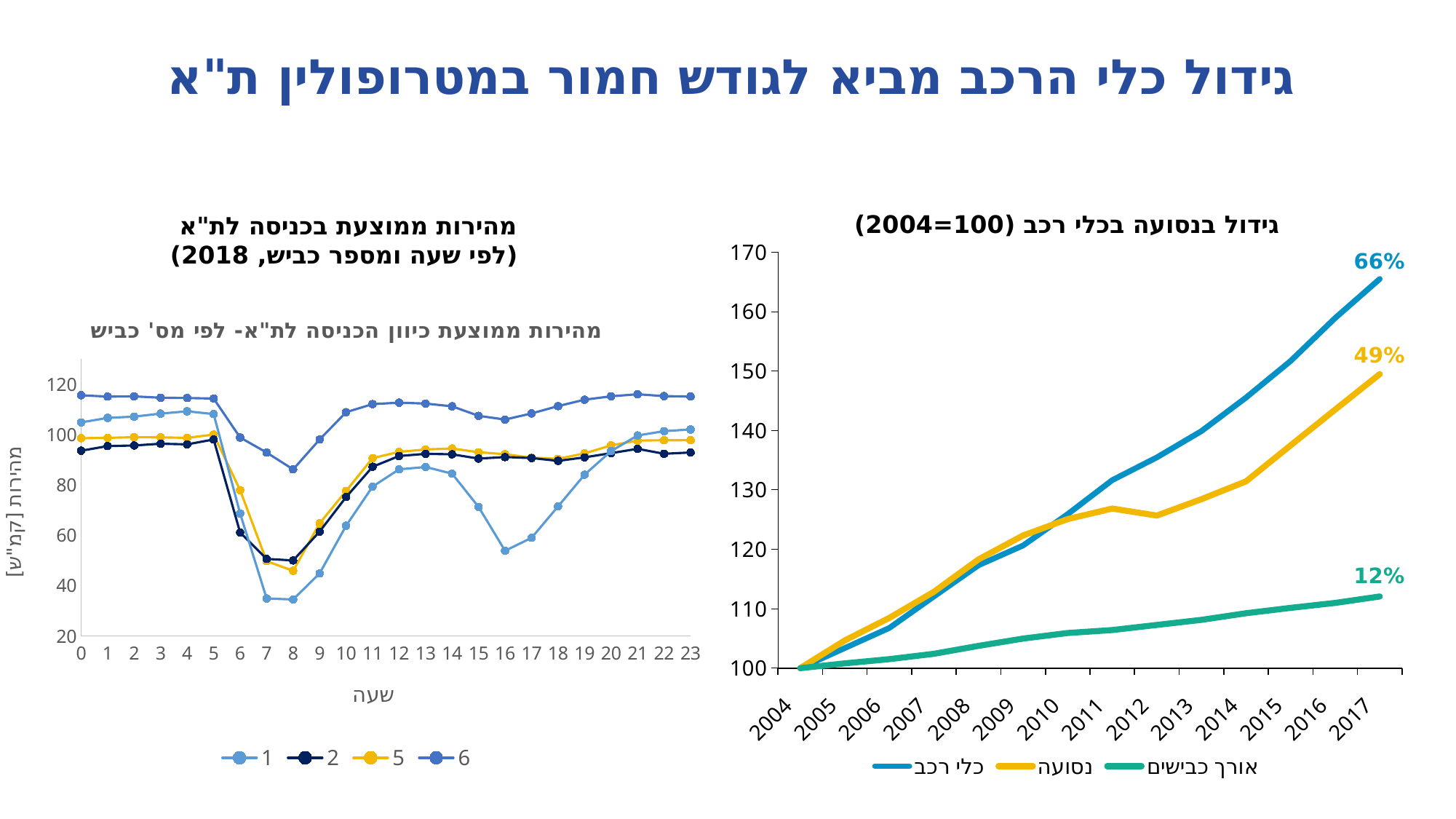
How many series does the legend of the right-hand chart (גידול בנסועה בכלי רכב) list? 3 In the left-hand chart (מהירות ממוצעת בכניסה לת"א), is the value for series 1 at hour 7 greater or less than 40? less In the right-hand chart (גידול בנסועה בכלי רכב), how many years are shown on the x axis? 14 In the right-hand chart (גידול בנסועה בכלי רכב), which series shows the highest growth by 2017? כלי רכב In the right-hand chart (גידול בנסועה בכלי רכב), what percentage label is shown at the end of the נסועה line? 49% What kind of chart is the right-hand chart titled "גידול בנסועה בכלי רכב (2004=100)"? line chart How many series does the legend of the left-hand chart (מהירות ממוצעת בכניסה לת"א) list? 4 In the right-hand chart (גידול בנסועה בכלי רכב), do the values of the כלי רכב series rise or fall from 2004 to 2017? rise In the right-hand chart (גידול בנסועה בכלי רכב), what percentage label is shown at the end of the כלי רכב line? 66% In the right-hand chart (גידול בנסועה בכלי רכב), which series shows the lowest growth by 2017? אורך כבישים In the right-hand chart (גידול בנסועה בכלי רכב), what percentage label is shown at the end of the אורך כבישים line? 12% In the left-hand chart (מהירות ממוצעת בכניסה לת"א), at hour 16, which series has the larger value: 1 or 6? 6